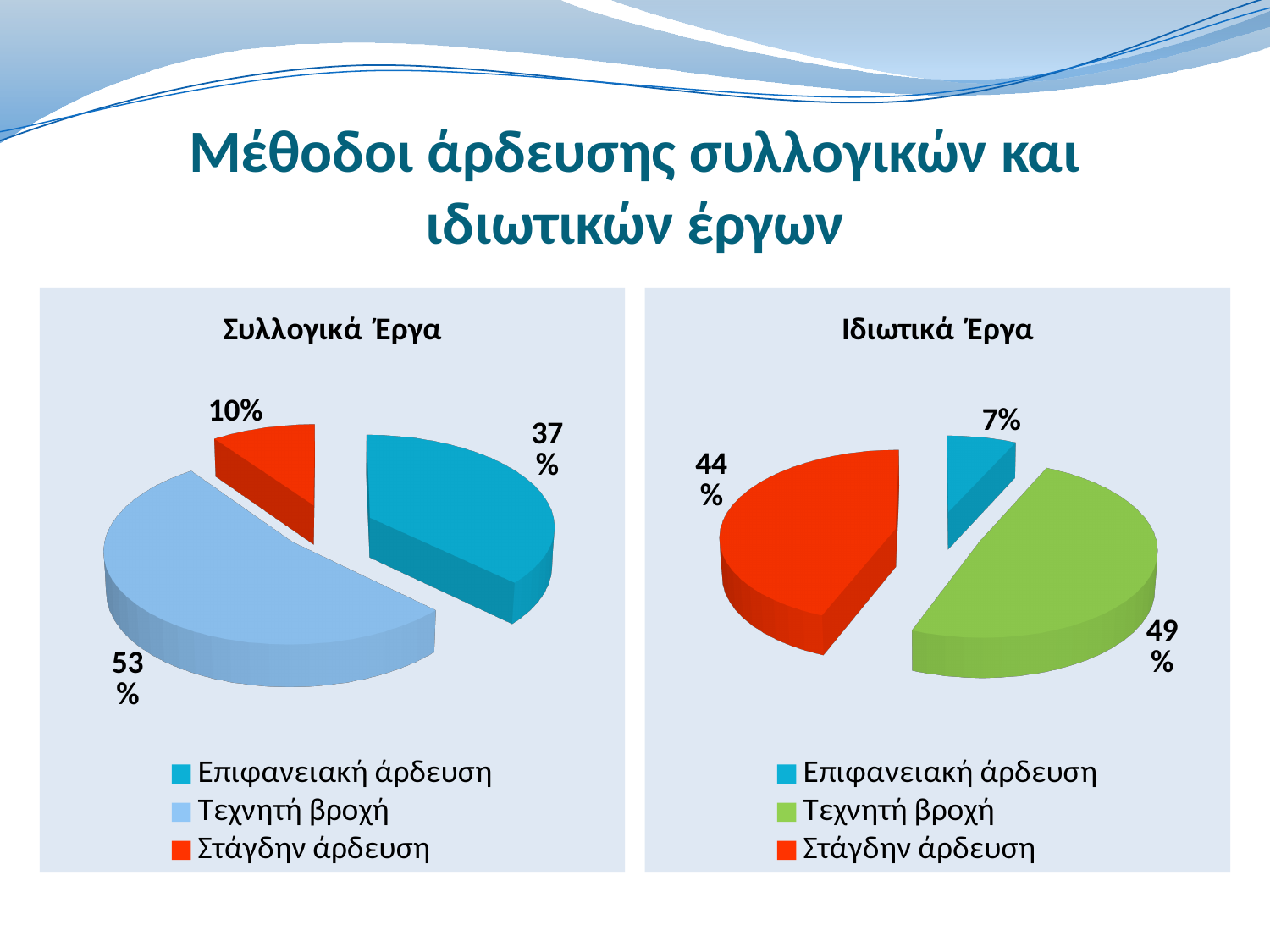
In the "Ιδιωτικά Έργα" chart, which category has the smallest share? Επιφανειακή άρδευση How many slices does the "Ιδιωτικά Έργα" chart have? 3 In the "Ιδιωτικά Έργα" chart, what share does Επιφανειακή άρδευση have? 7% In the "Συλλογικά Έργα" chart, which category has the largest share? Τεχνητή βροχή In the "Συλλογικά Έργα" chart, what share does Στάγδην άρδευση have? 10% In the "Συλλογικά Έργα" chart, what share does Τεχνητή βροχή have? 53% What type of chart is the "Συλλογικά Έργα" chart? Pie chart In the "Ιδιωτικά Έργα" chart, what colour is the Τεχνητή βροχή slice? Green In the "Συλλογικά Έργα" chart, what is the difference in percentage points between Τεχνητή βροχή and Επιφανειακή άρδευση? 16 In the "Ιδιωτικά Έργα" chart, which is larger: Τεχνητή βροχή or Στάγδην άρδευση? Τεχνητή βροχή What is the title of the chart on the left of the slide? Συλλογικά Έργα In the "Ιδιωτικά Έργα" chart, what share does Στάγδην άρδευση have? 44%